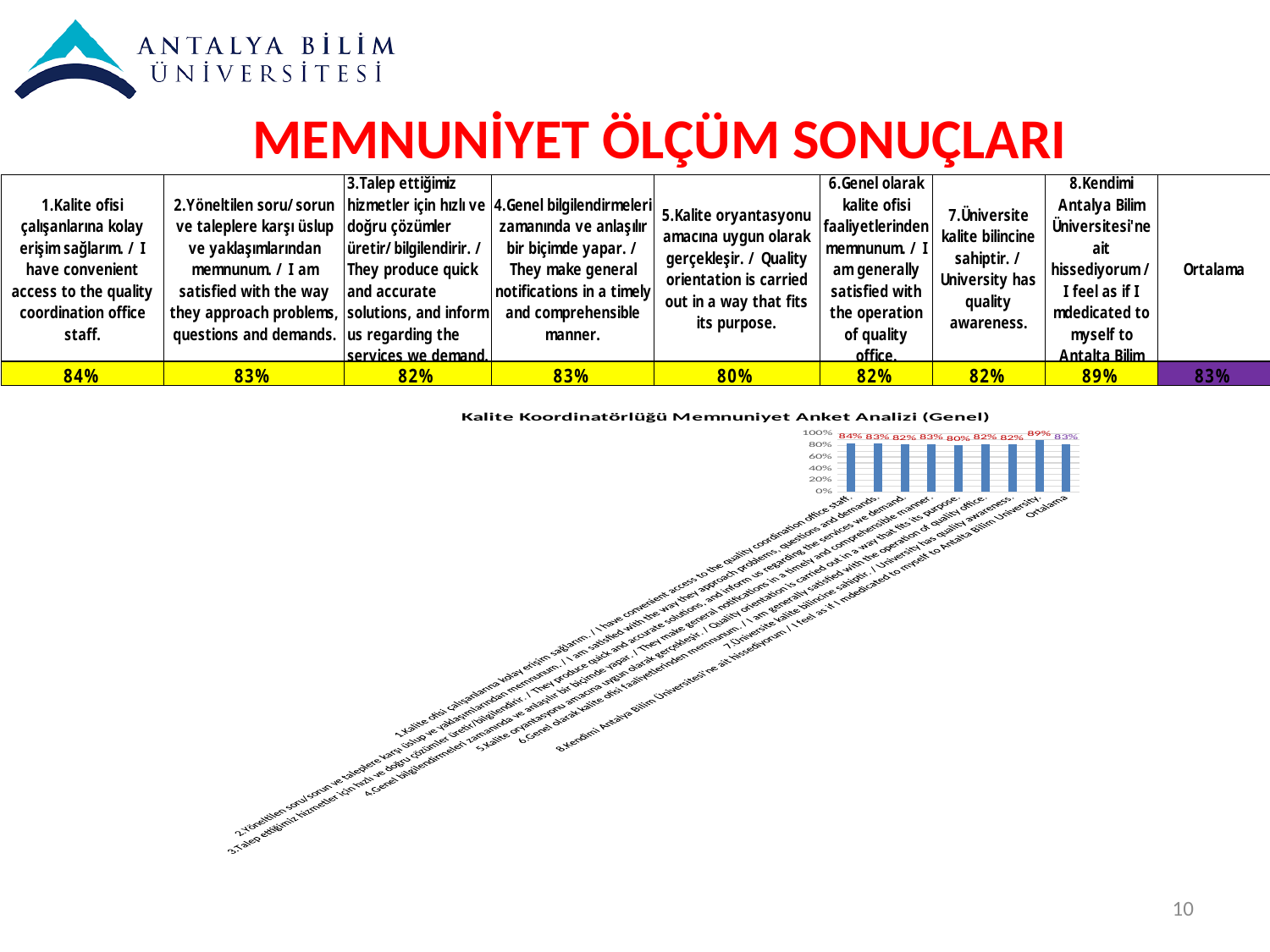
What value does the chart show for item 5 (Kalite oryantasyonu amacına uygun olarak gerçekleşir)? 80% What value does the chart show for item 8 (Kendimi Antalya Bilim Üniversitesi'ne ait hissediyorum)? 89% Which category has the highest value in the chart? 8.Kendimi Antalya Bilim Üniversitesi'ne ait hissediyorum Which category has the lowest value in the chart? 5.Kalite oryantasyonu amacına uygun olarak gerçekleşir What type of chart is shown on the slide? bar chart What is the title of the chart on the slide? Kalite Koordinatörlüğü Memnuniyet Anket Analizi (Genel) What is the difference between the highest value (item 8) and the lowest value (item 5) in the chart? 9% What value does the chart show for Ortalama? 83% Is the value for item 7 (Üniversite kalite bilincine sahiptir) greater or less than 60%? greater How many bars are plotted in the chart? 9 What value does the chart show for item 1 (Kalite ofisi çalışanlarına kolay erişim sağlarım)? 84% Which is larger in the chart: the value for item 1 or the value for item 5? item 1